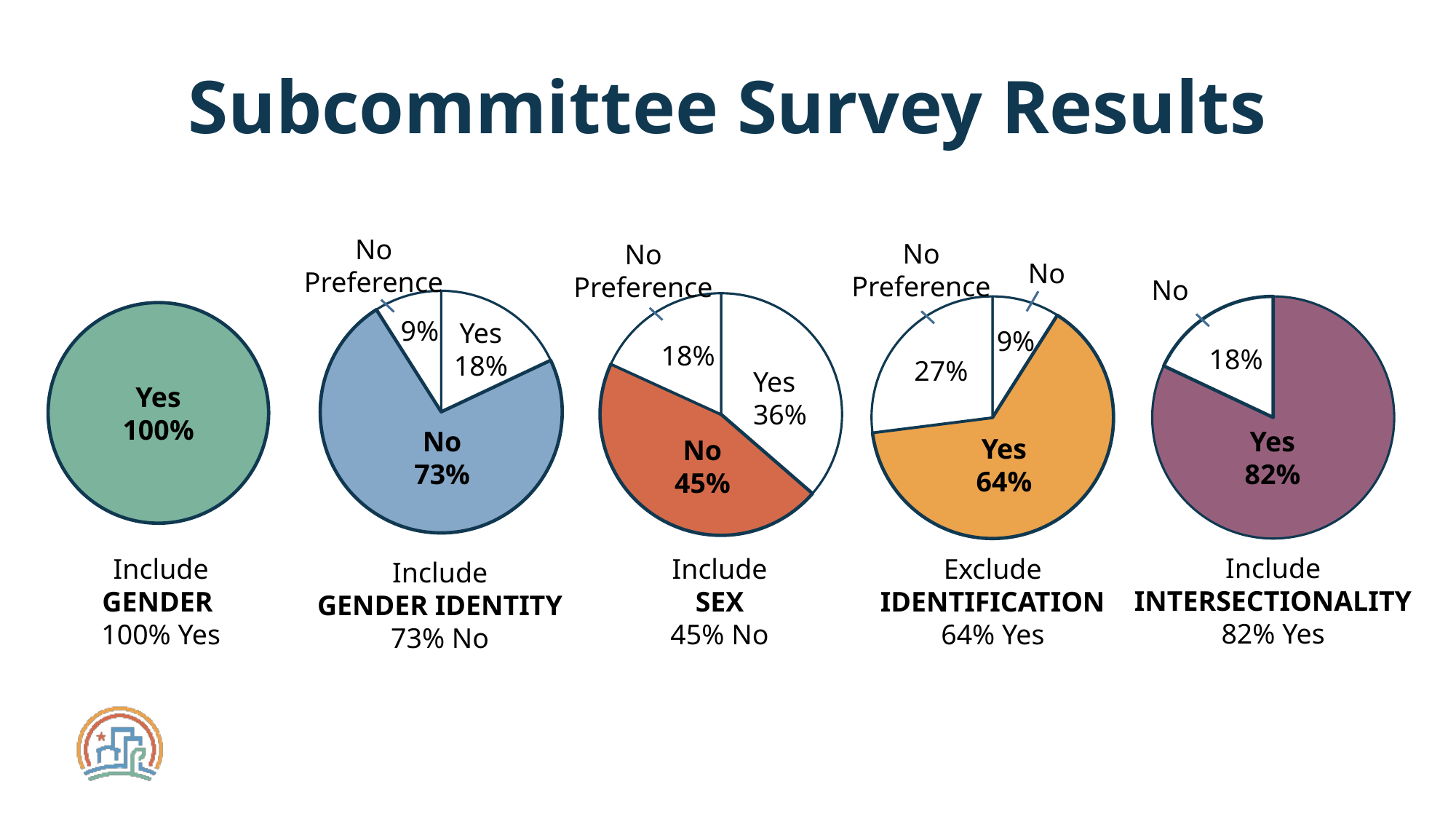
What kind of chart is used to show the Include INTERSECTIONALITY results? Pie chart In the Include SEX pie chart, what share of responses was Yes? 36% In the Include SEX pie chart, which response has the largest share? No In the Exclude IDENTIFICATION pie chart, which response has the smallest share? No In the Exclude IDENTIFICATION pie chart, what share of responses was No Preference? 27% In the Include GENDER IDENTITY pie chart, what is the difference between the No share and the Yes share? 55% In the Include SEX pie chart, which is larger, the Yes share or the No Preference share? Yes How many slices does the Include GENDER IDENTITY pie chart have? 3 In the Include GENDER IDENTITY pie chart, what share of responses was No? 73% In the Include INTERSECTIONALITY pie chart, what share of responses was No? 18% In the Include GENDER pie chart, what share of responses was Yes? 100% How many pie charts are shown on the slide? 5